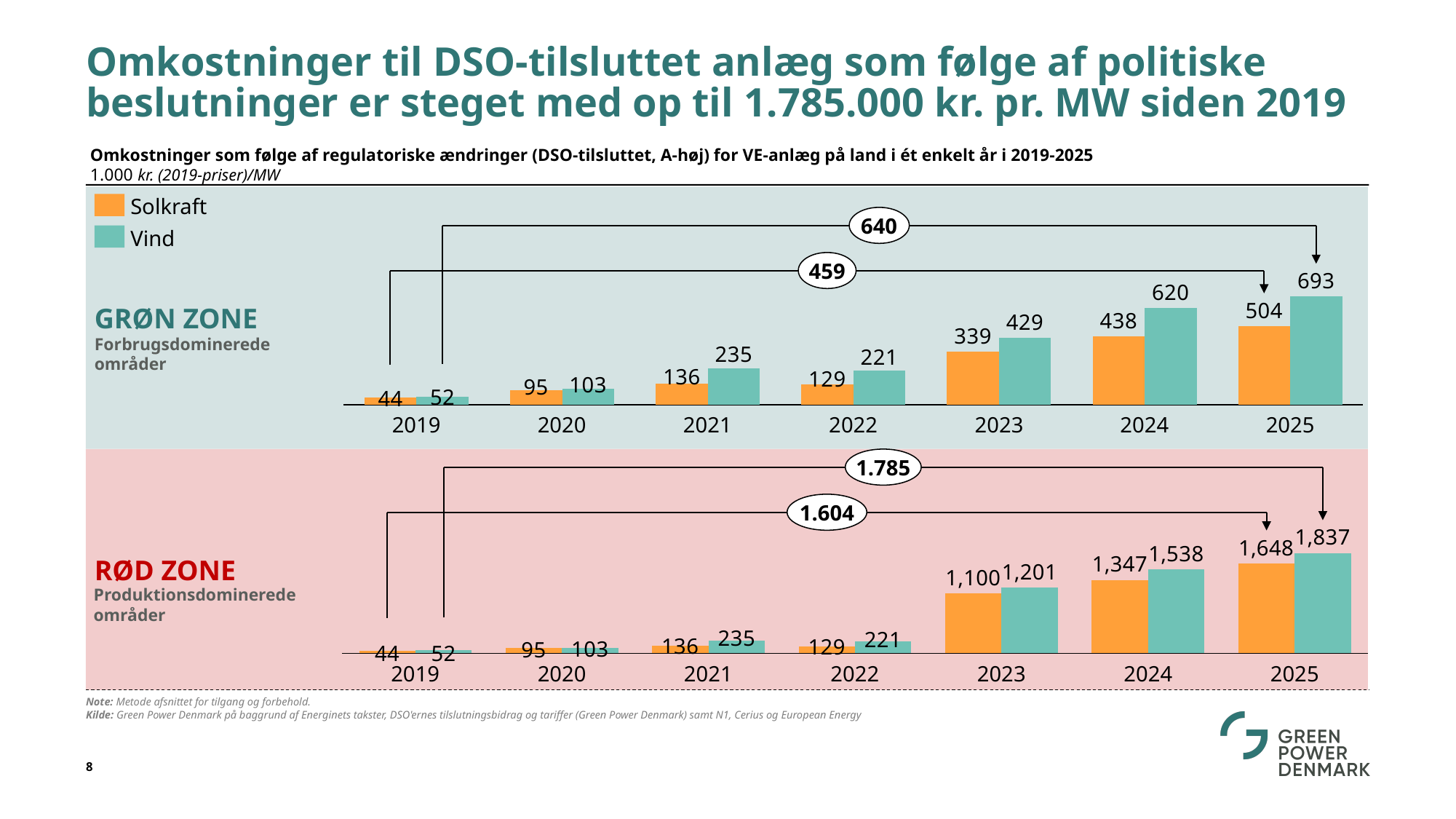
In the RØD ZONE chart, what is the value for Vind in 2025? 1,837 In the GRØN ZONE chart, which year has the highest Vind value? 2025 How many series does the legend list? 2 In the GRØN ZONE chart, what is the difference between the Vind and Solkraft values in 2025? 189 In the GRØN ZONE chart, what is the value for Solkraft in 2023? 339 In the GRØN ZONE chart, which is larger in 2022: Solkraft or Vind? Vind In the RØD ZONE chart, what is the difference between the Solkraft values for 2025 and 2023? 548 In the RØD ZONE chart, what is the value for Solkraft in 2024? 1,347 In the GRØN ZONE chart, what is the value for Vind in 2024? 620 How many years are shown on the x axis of the RØD ZONE chart? 7 In the RØD ZONE chart, which year has the lowest Solkraft value? 2019 What kind of chart is the GRØN ZONE chart? Bar chart